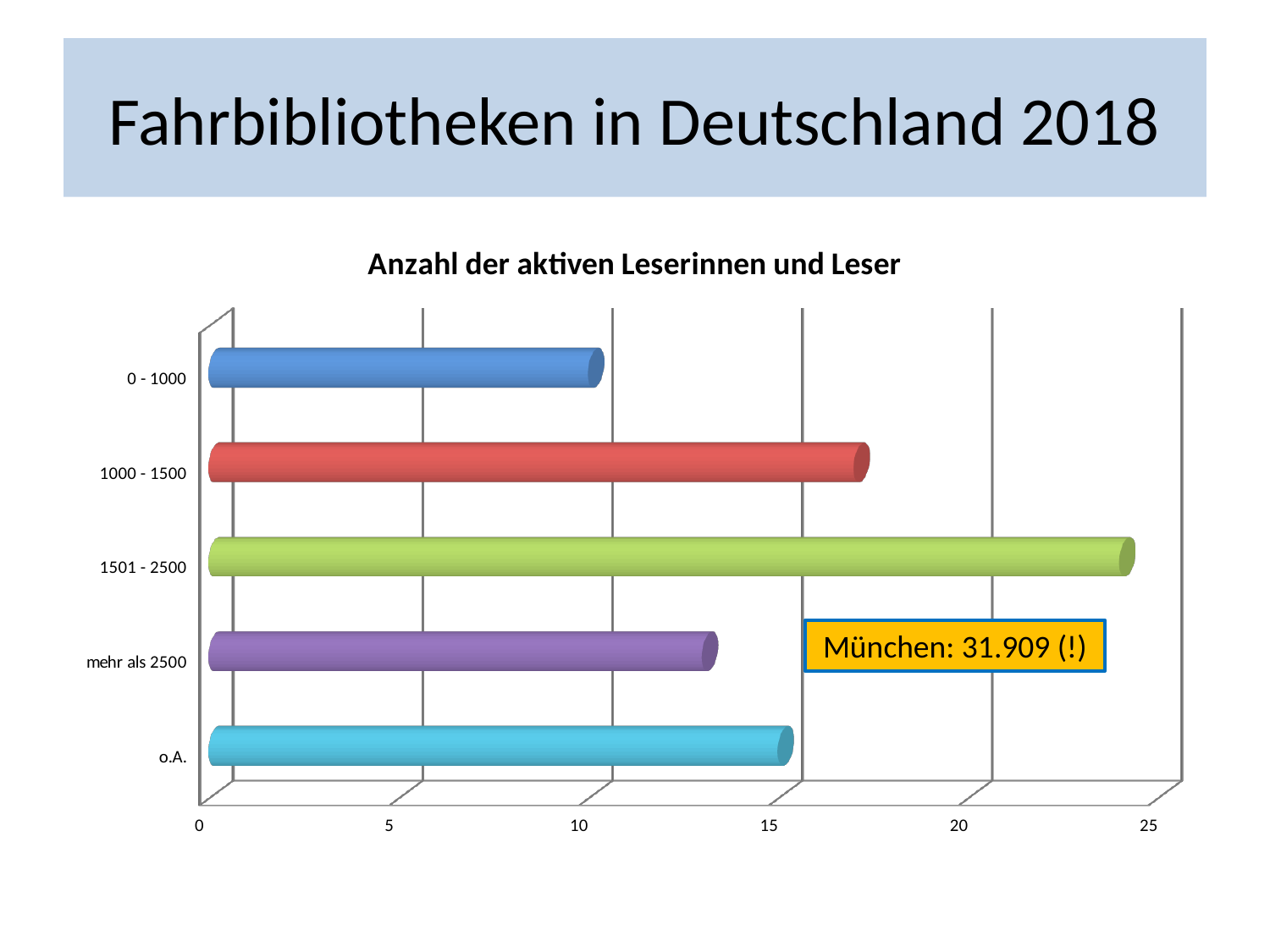
How many categories are shown on the chart? 5 Is the value for mehr als 2500 greater or less than 15? less Which category has the highest value? 1501 - 2500 What kind of chart is shown on the slide? bar chart Is the value for 1000 - 1500 greater or less than 15? greater Is the value for 0 - 1000 greater or less than 15? less What value is given for München in the highlighted box on the chart? 31.909 (!) What is the title of the chart? Anzahl der aktiven Leserinnen und Leser Which is larger, the value for 1000 - 1500 or the value for mehr als 2500? 1000 - 1500 Which category has the lowest value? 0 - 1000